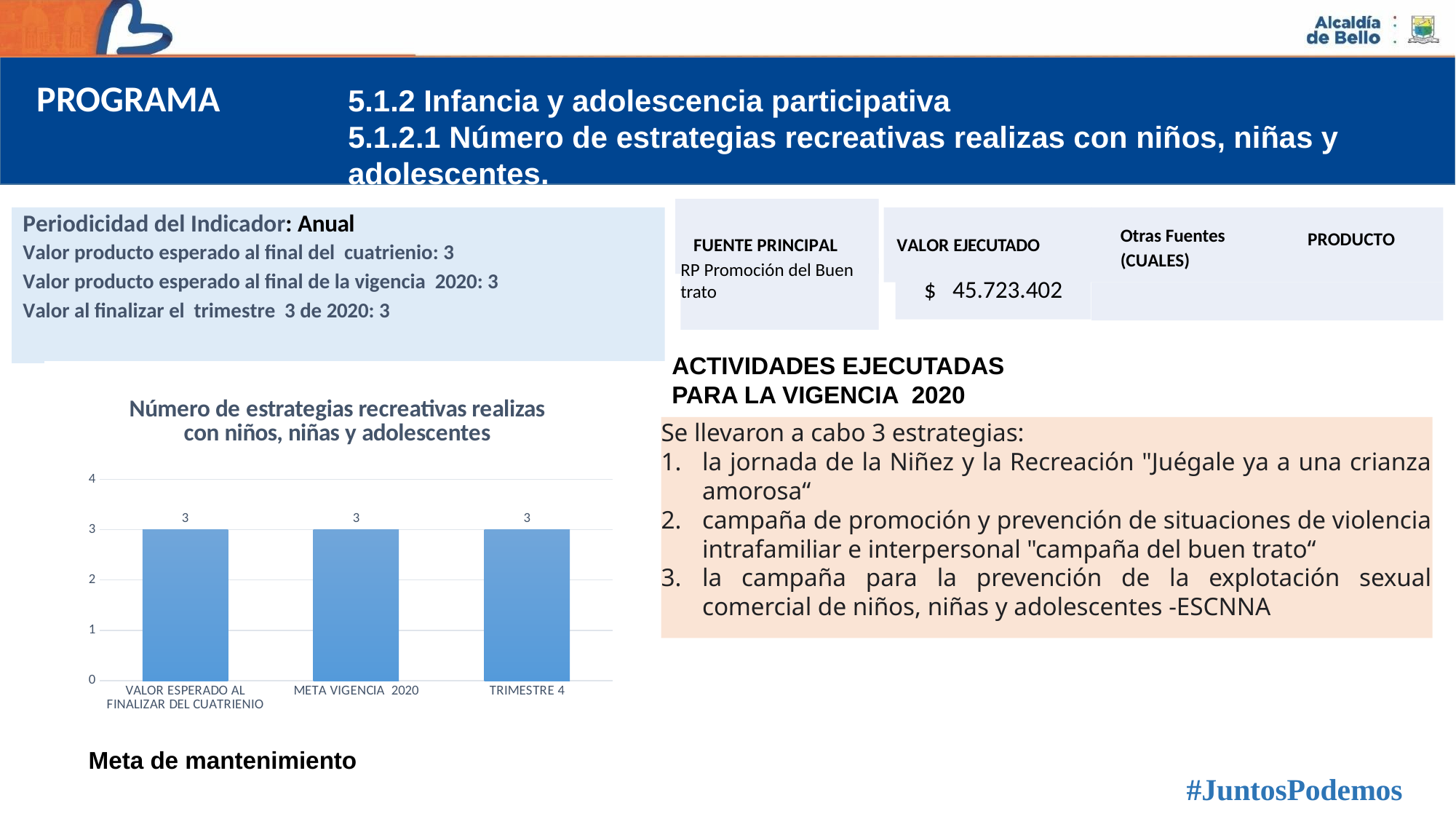
What is the value for TRIMESTRE 4? 3 Do the values rise, fall, or stay the same across the categories from left to right? stay the same Is the value for VALOR ESPERADO AL FINALIZAR DEL CUATRIENIO greater or less than 4? less What is the highest value shown on the chart's y axis? 4 What kind of chart is shown on the slide? bar chart What is the title of the chart? Número de estrategias recreativas realizas con niños, niñas y adolescentes What is the value for META VIGENCIA 2020? 3 How many categories are shown on the x axis of the chart? 3 Is the value for TRIMESTRE 4 greater or less than 2? greater What is the difference between the value for TRIMESTRE 4 and the value for META VIGENCIA 2020? 0 What is the value for VALOR ESPERADO AL FINALIZAR DEL CUATRIENIO? 3